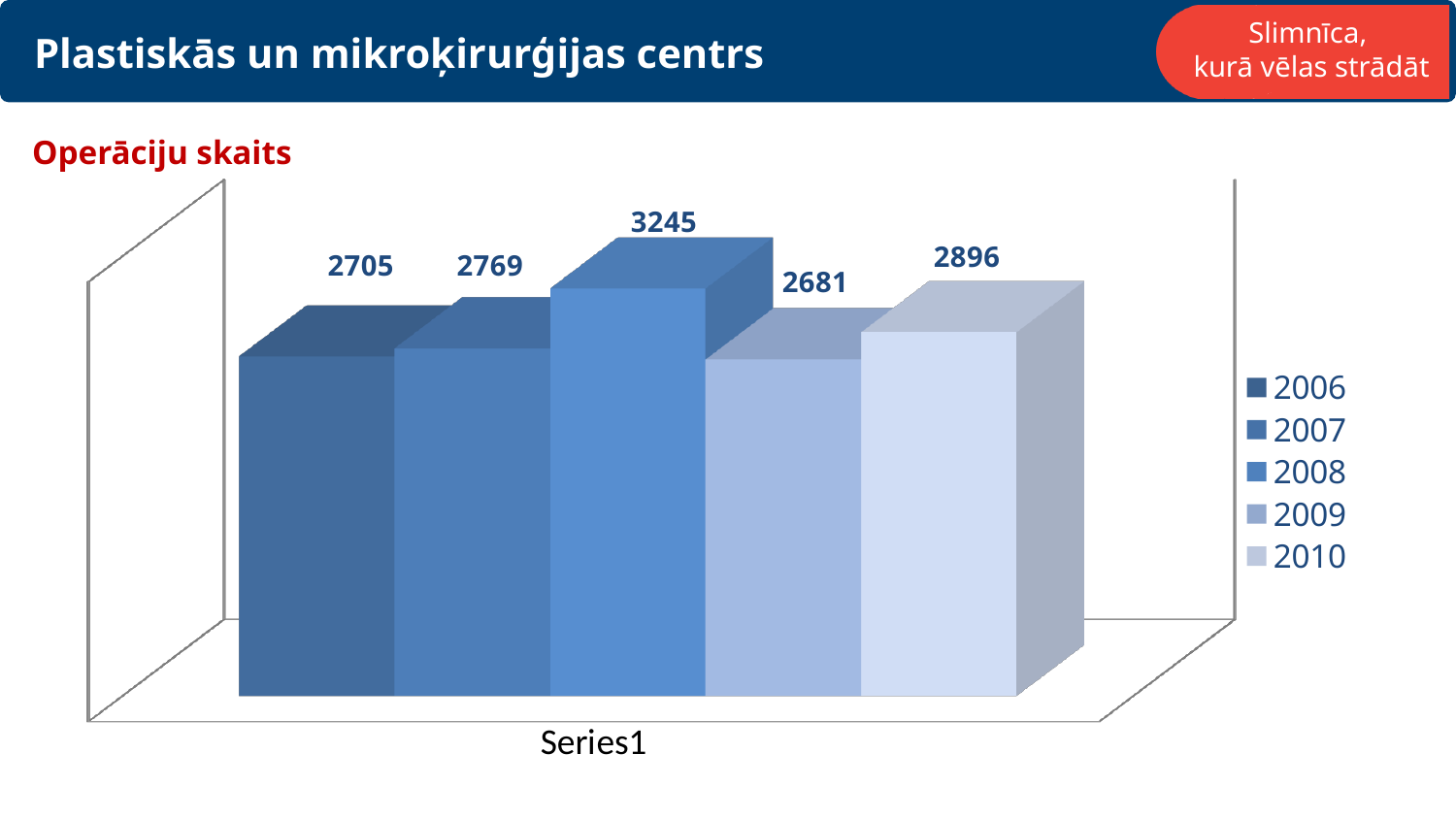
What is the number of operations shown for 2008? 3245 How many series does the legend list? 5 What is the difference between the values for 2008 and 2009? 564 What value is shown for 2010? 2896 What is the title of the chart? Operāciju skaits Which is larger, the value for 2007 or the value for 2010? 2010 What value is shown for 2006? 2705 What label is shown on the horizontal axis of the chart? Series1 What is the difference between the values for 2010 and 2006? 191 What kind of chart is shown on the slide? Bar chart Which year has the highest value? 2008 Which year has the lowest value? 2009